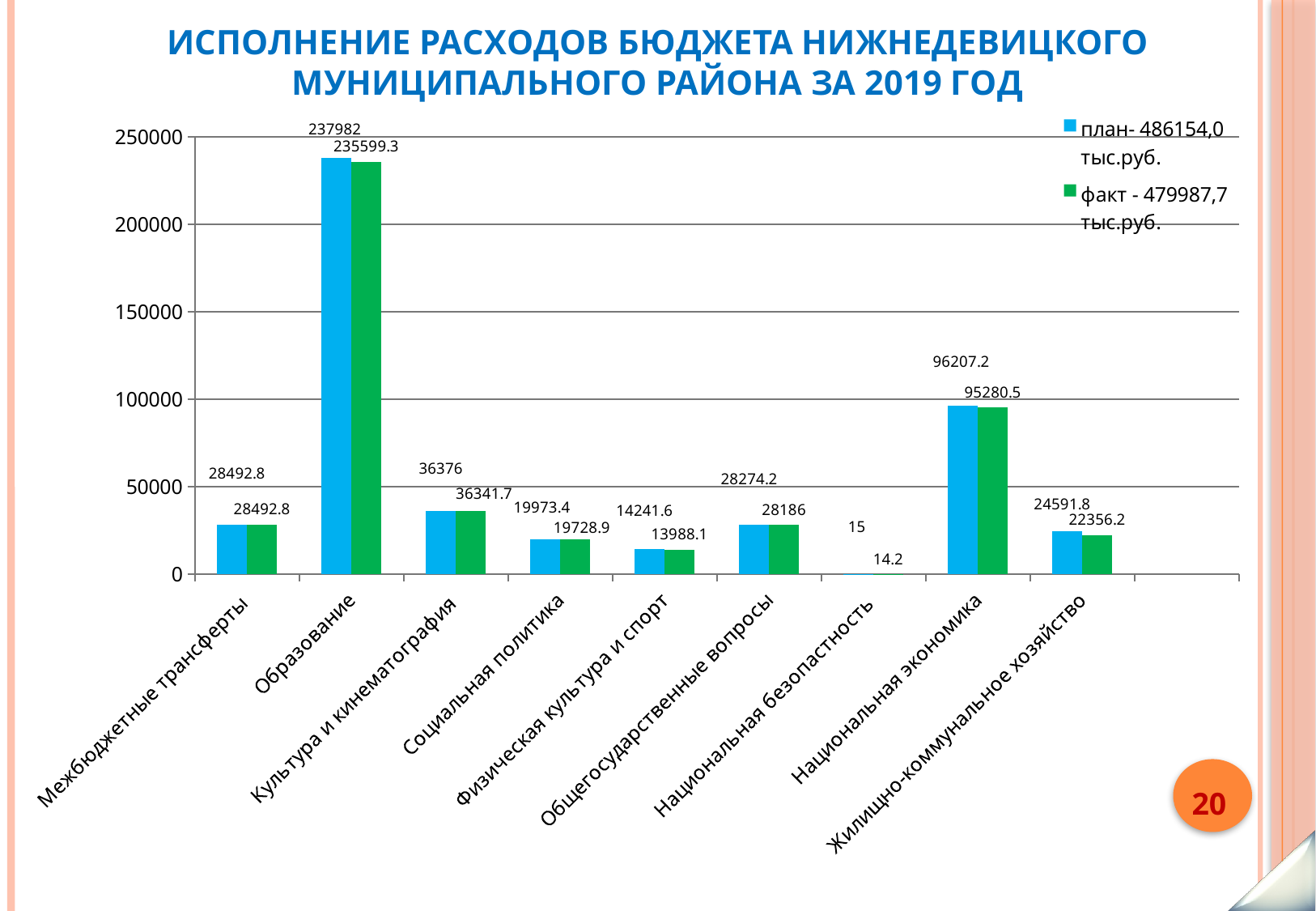
How many categories are shown on the x axis? 9 What is the план value for Образование? 237982 What is the факт value for Жилищно-коммунальное хозяйство? 22356.2 What is the difference between the план and факт values for Жилищно-коммунальное хозяйство? 2235.6 Which category has the highest план value? Образование How many series does the legend list? 2 What is the difference between the план and факт values for Образование? 2382.7 Which is larger: the план value for Национальная экономика or the план value for Культура и кинематография? Национальная экономика What is the план value for Национальная безопасность? 15 Which category has the lowest факт value? Национальная безопасность What kind of chart is shown on the slide? Bar chart What is the факт value for Национальная экономика? 95280.5